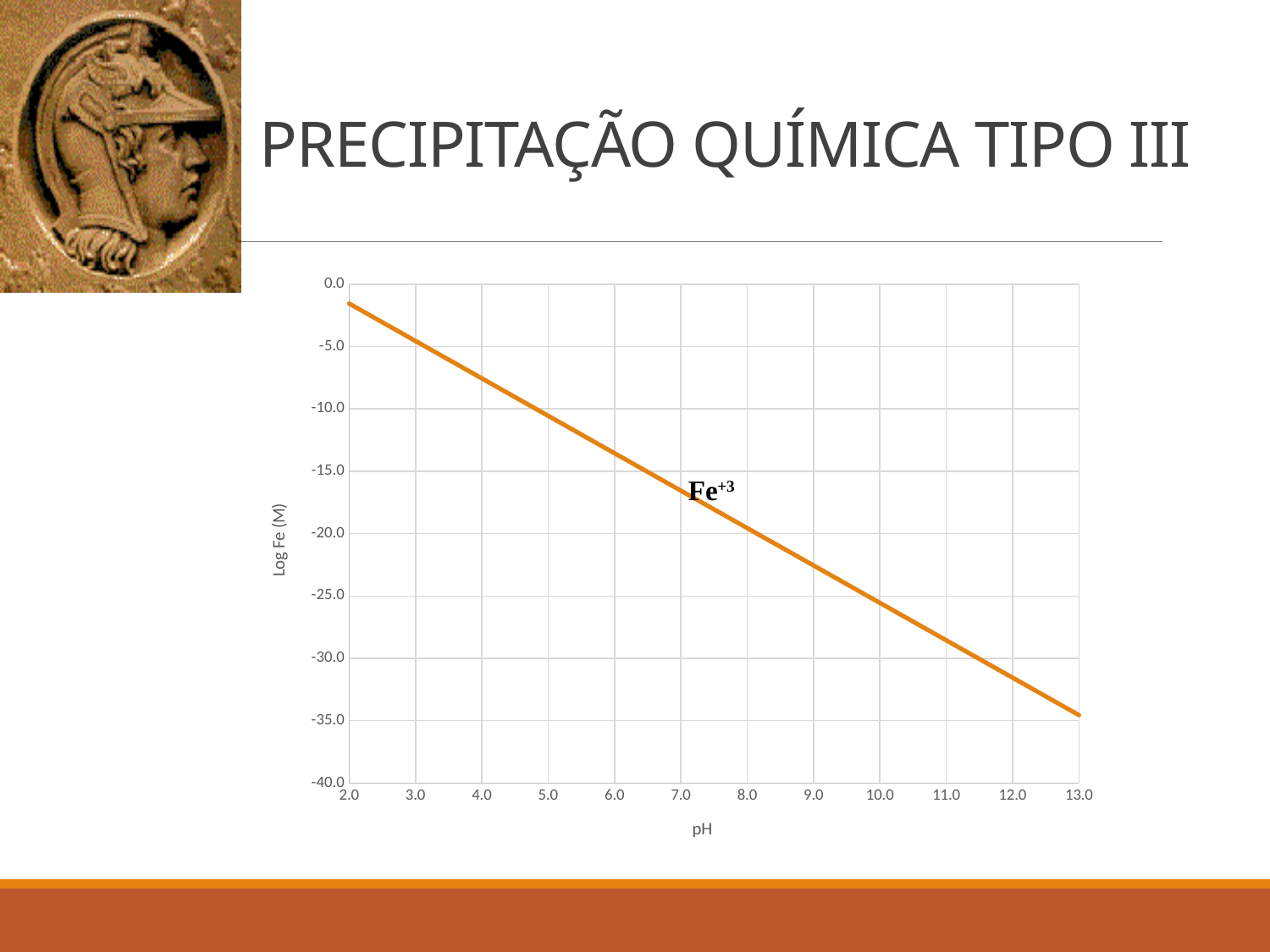
Does the Log Fe (M) value rise or fall as pH increases along the x axis? fall Is the Log Fe (M) value at pH 9.0 greater or less than -20.0? less Is the Log Fe (M) value at pH 4.0 greater or less than -10.0? greater Is the Log Fe (M) value at pH 2.0 greater or less than -5.0? greater What is the label on the x axis of the chart? pH Which has the larger Log Fe (M) value, pH 3.0 or pH 11.0? pH 3.0 What species is the plotted line labelled as? Fe+3 What kind of chart is shown on the slide? line chart